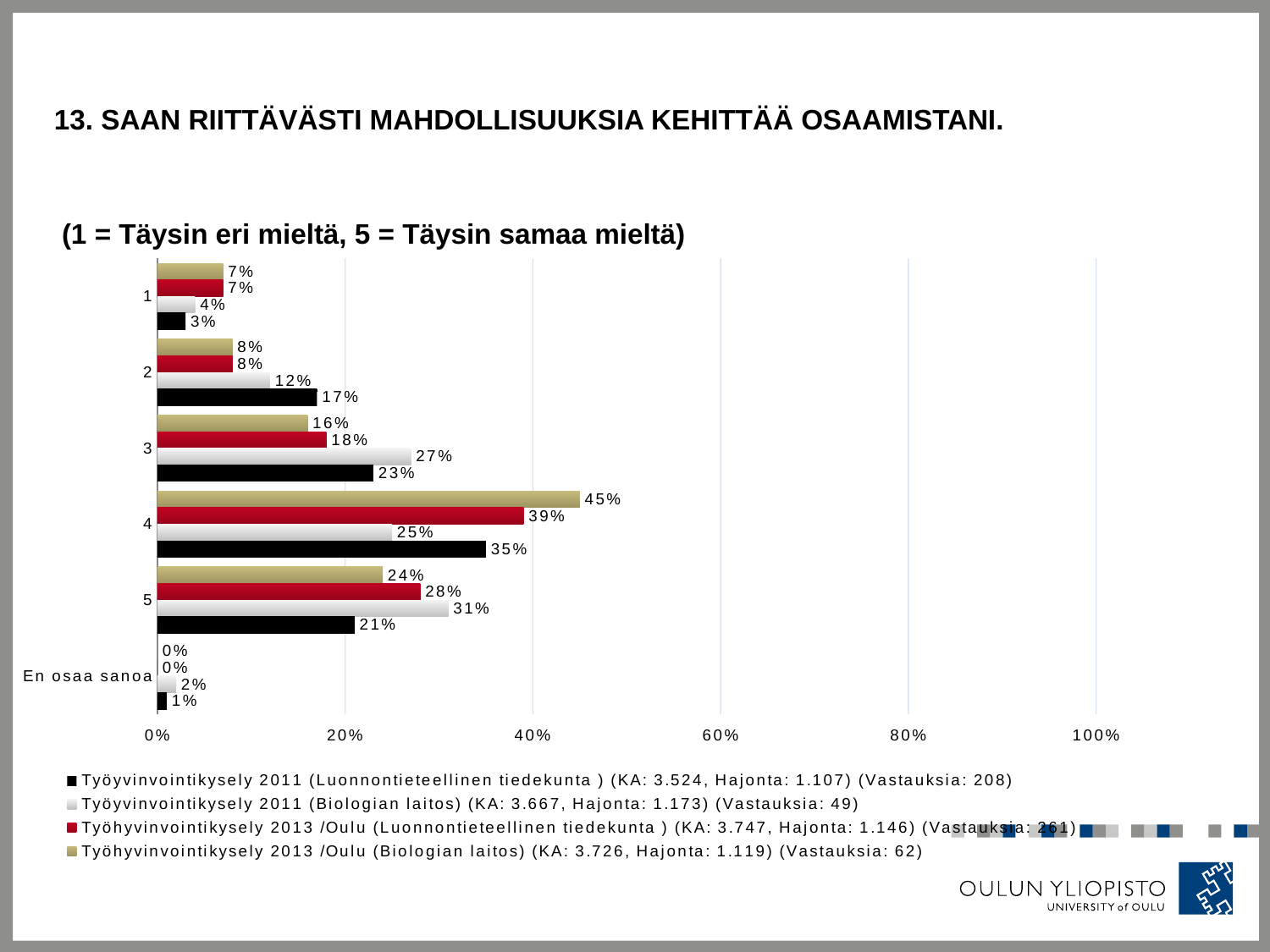
What kind of chart is shown on the slide? bar chart What is the value for category 5 in the Työyvinvointikysely 2011 (Biologian laitos) series? 31% What is the value for category 3 in the Työhyvinvointikysely 2013 /Oulu (Luonnontieteellinen tiedekunta) series? 18% Which category has the highest value in the Työhyvinvointikysely 2013 /Oulu (Biologian laitos) series? 4 How many categories are shown on the vertical axis of the chart? 6 How many series does the legend list? 4 For category 3, which series has the larger value: Työyvinvointikysely 2011 (Biologian laitos) or Työyvinvointikysely 2011 (Luonnontieteellinen tiedekunta)? Työyvinvointikysely 2011 (Biologian laitos) Is the value for category 4 in the Työhyvinvointikysely 2013 /Oulu (Luonnontieteellinen tiedekunta) series greater or less than 20%? greater What is the value for category 2 in the Työyvinvointikysely 2011 (Luonnontieteellinen tiedekunta) series? 17% What is the value for category 4 in the Työhyvinvointikysely 2013 /Oulu (Biologian laitos) series? 45% What is the difference between the Työhyvinvointikysely 2013 /Oulu (Biologian laitos) value and the Työyvinvointikysely 2011 (Biologian laitos) value for category 4? 20% Which category has the lowest value in the Työyvinvointikysely 2011 (Luonnontieteellinen tiedekunta) series? En osaa sanoa